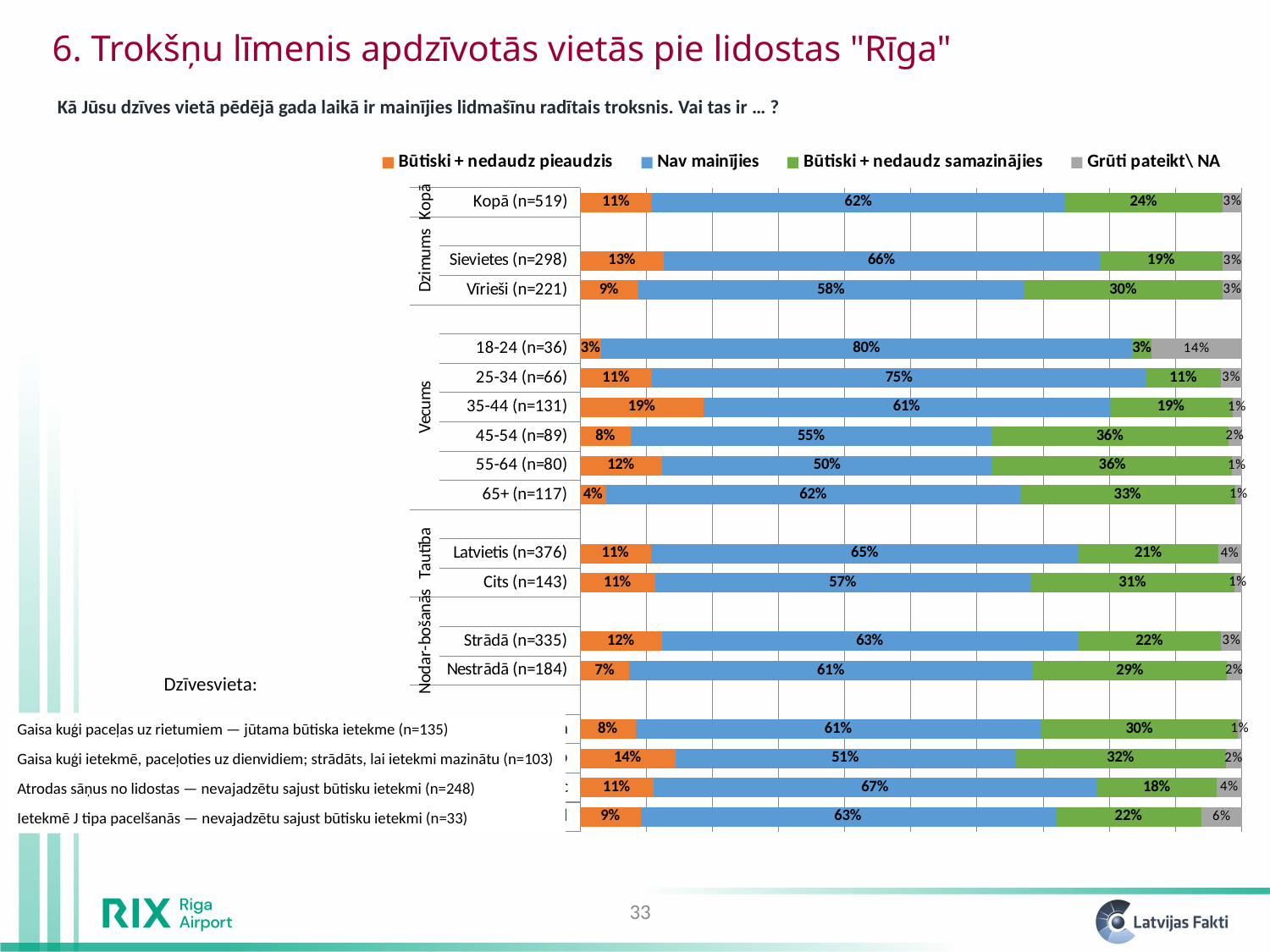
How many series does the legend list? 4 Which is larger: the "Būtiski + nedaudz pieaudzis" value for Strādā (n=335) or for Nestrādā (n=184)? Strādā (n=335) Which category has the lowest value for "Nav mainījies"? 55-64 (n=80) What is the difference between the "Būtiski + nedaudz samazinājies" values for Vīrieši (n=221) and Sievietes (n=298)? 11% What kind of chart is shown on the slide? Stacked bar chart How many category bars are plotted in the chart? 17 What is the value of "Nav mainījies" for Kopā (n=519)? 62% Which category has the highest value for "Nav mainījies"? 18-24 (n=36) Which colour represents the "Nav mainījies" series? Blue What is the total of the stacked bar for 45-54 (n=89)? 101% What is the value of "Grūti pateikt\ NA" for 18-24 (n=36)? 14% What is the value of "Būtiski + nedaudz pieaudzis" for 35-44 (n=131)? 19%